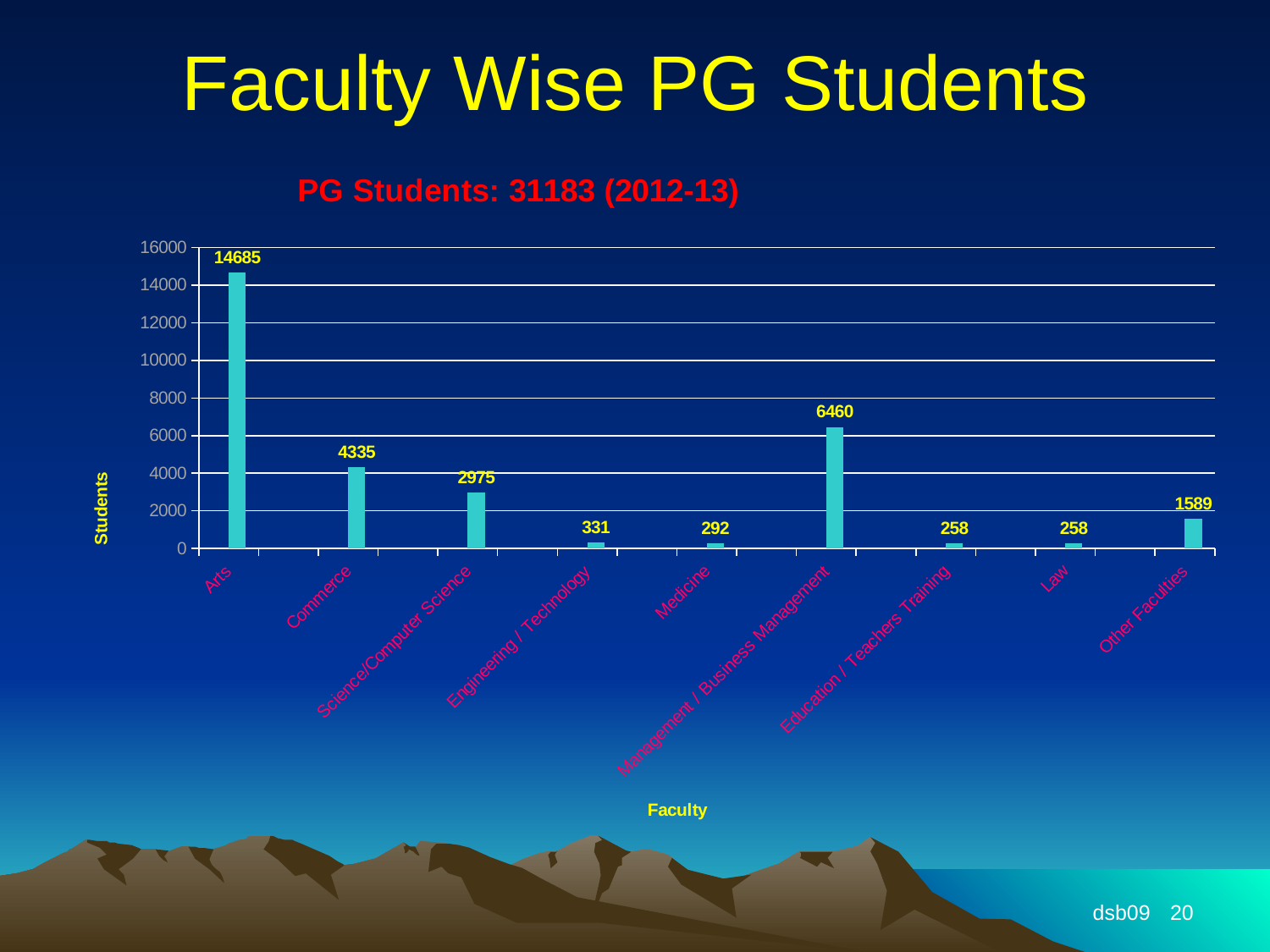
Which is larger, the value for Engineering / Technology or the value for Medicine? Engineering / Technology What is the label of the y axis? Students What is the difference between the values for Commerce and Science/Computer Science? 1360 What is the value for Medicine? 292 What is the value for Management / Business Management? 6460 How many PG students are in the Arts faculty? 14685 What is the difference between the values for Arts and Management / Business Management? 8225 What is the value for Other Faculties? 1589 What is the title shown above the chart? PG Students: 31183 (2012-13) Which faculty has the highest number of PG students? Arts What kind of chart is shown on the slide? Bar chart How many faculty categories are shown on the x axis? 9